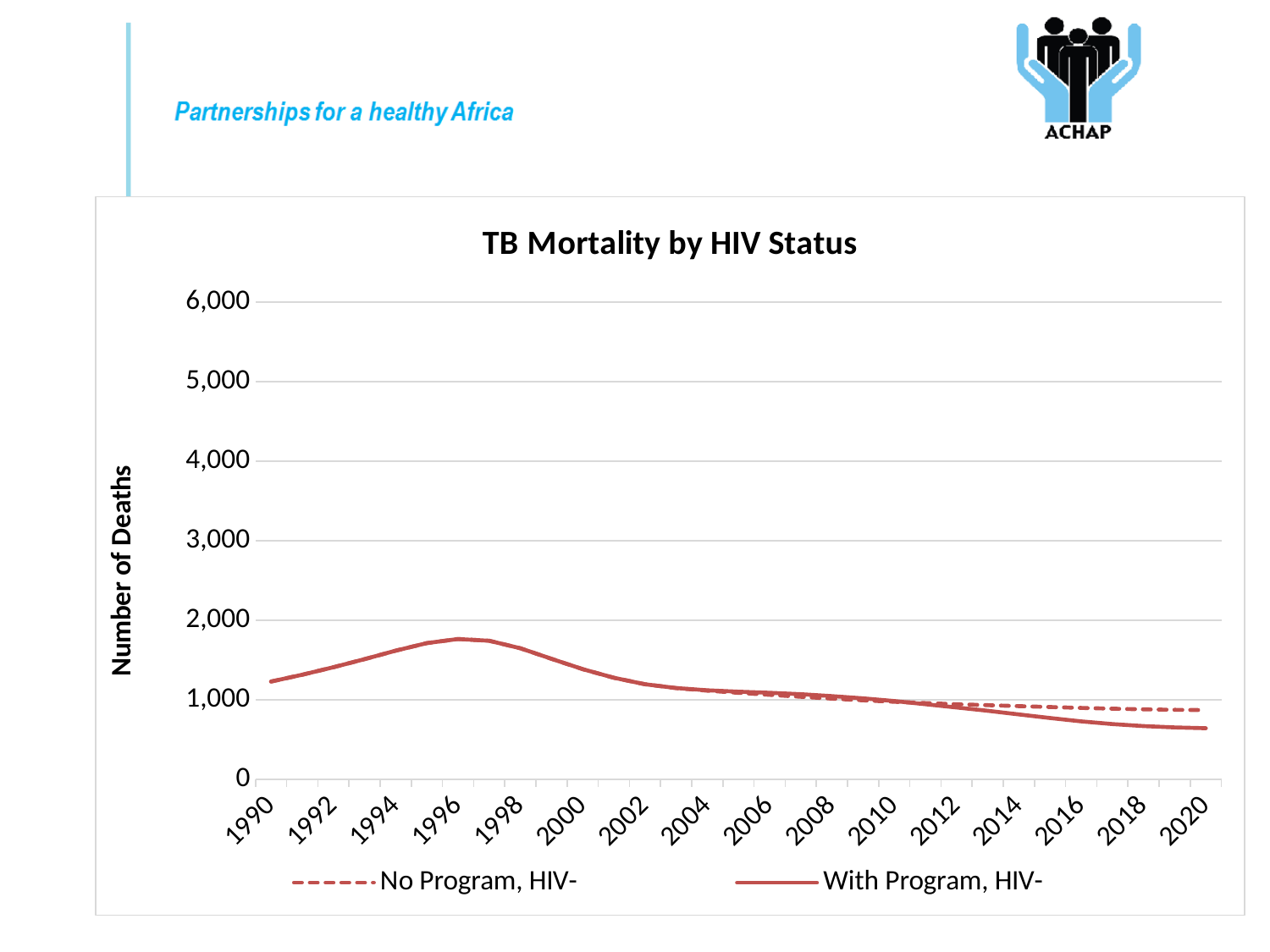
Do the values for 'With Program, HIV-' rise or fall between 2000 and 2020? Fall Is the highest value reached by the 'With Program, HIV-' line greater or less than 2,000? less Is the value for 'With Program, HIV-' in 1990 greater or less than 1,000? greater What is the title of the chart? TB Mortality by HIV Status How many year labels are shown on the x axis? 16 What is the label on the vertical axis? Number of Deaths Is the value for 'No Program, HIV-' in 2020 greater or less than 1,000? less In 2020, which series has the higher value: 'No Program, HIV-' or 'With Program, HIV-'? No Program, HIV- Do the values for 'With Program, HIV-' rise or fall between 1990 and 1996? Rise How many series does the legend list? 2 What kind of chart is shown on the slide? Line chart